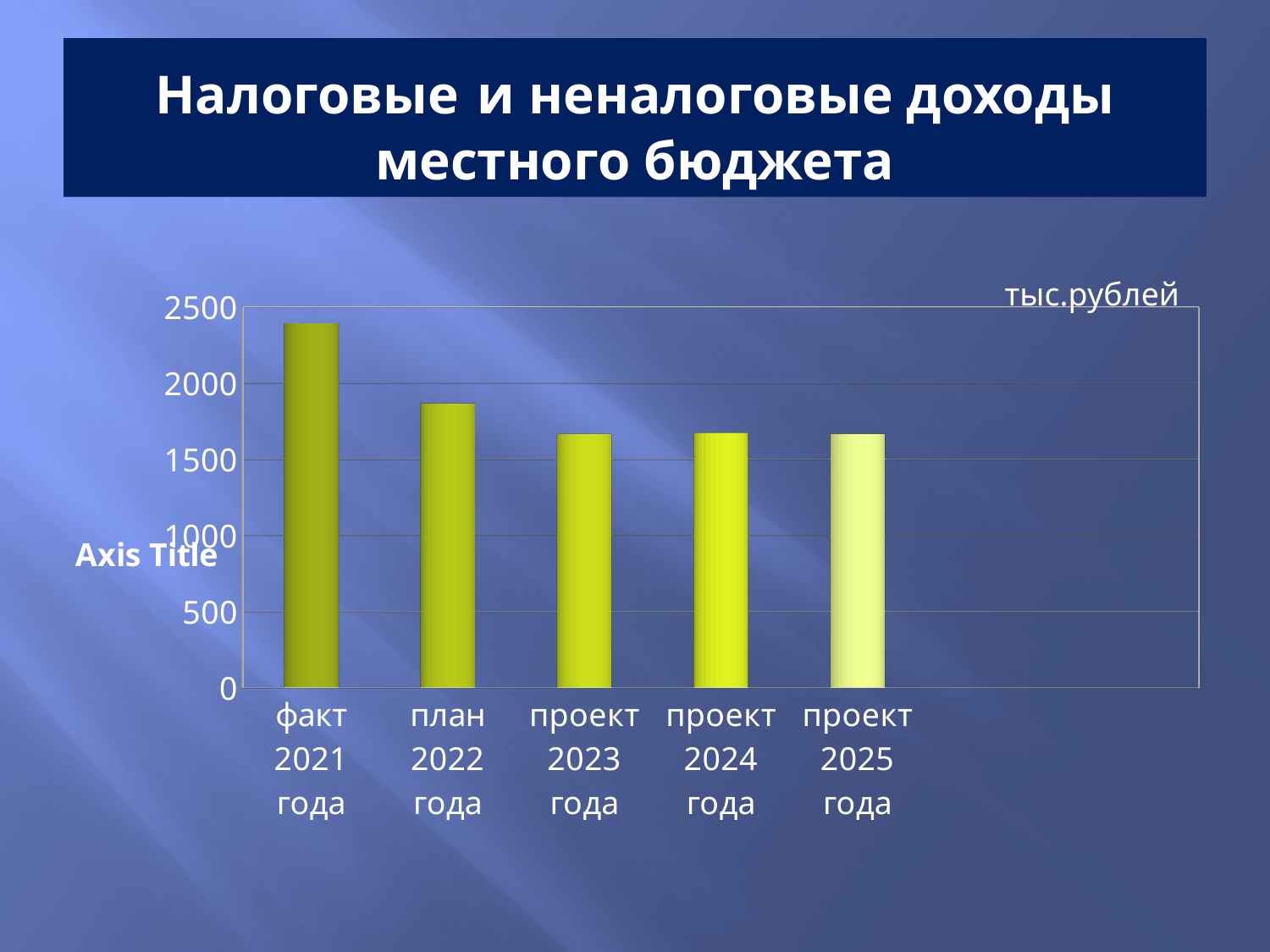
Do the values rise or fall from факт 2021 года to проект 2023 года? fall What unit label is shown above the chart? тыс.рублей Which is larger, the value for план 2022 года or the value for проект 2023 года? план 2022 года Is the value for план 2022 года greater or less than 1500? greater Is the value for план 2022 года greater or less than 2000? less Is the value for проект 2025 года greater or less than 2000? less Which is larger, the value for факт 2021 года or the value for план 2022 года? факт 2021 года How many bars (categories) does the chart show? 5 Which category has the highest value in the chart? факт 2021 года What kind of chart is shown on the slide? bar chart